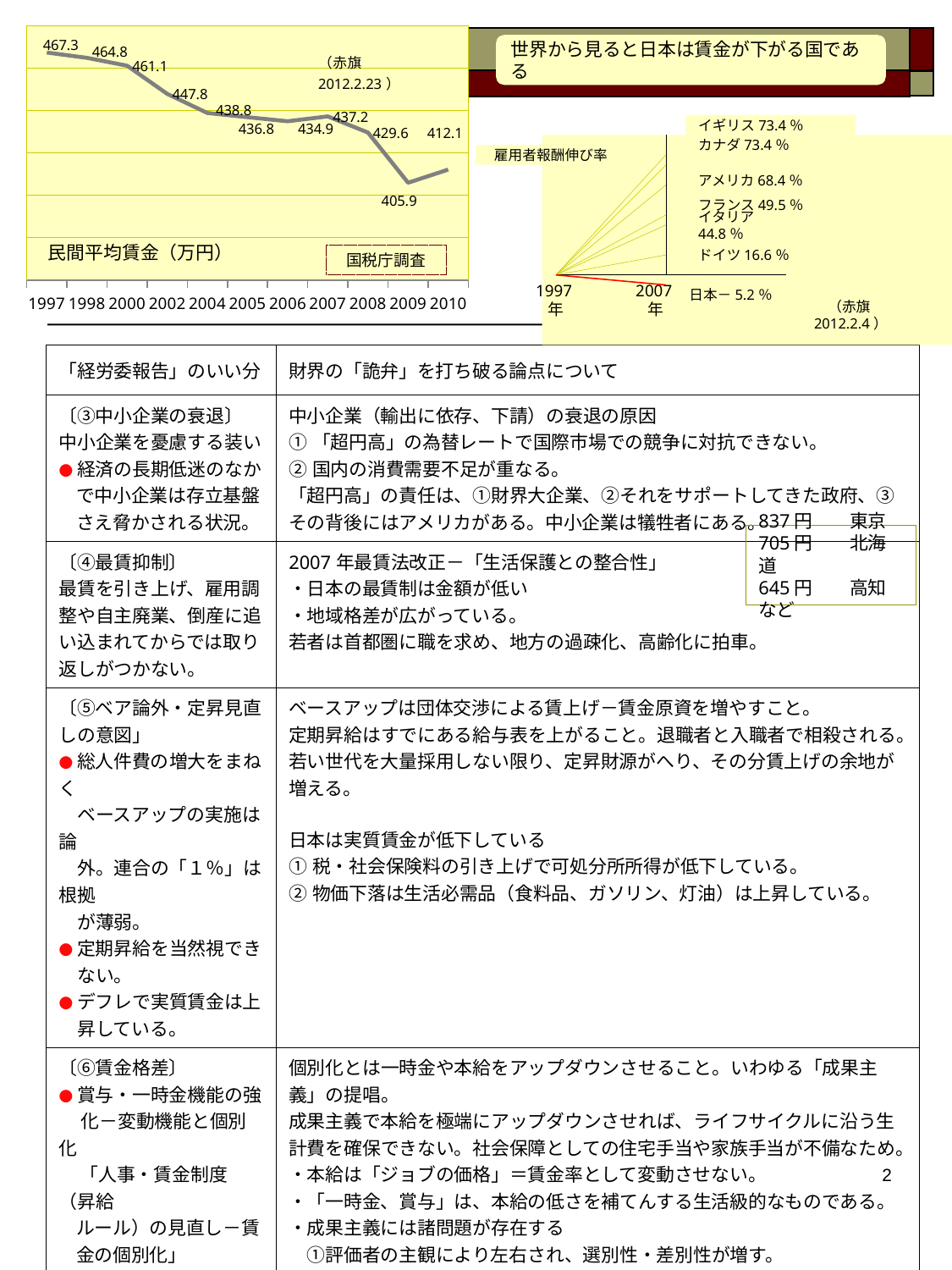
In the 民間平均賃金（万円） chart, what is the value for 2007? 437.2 In the 民間平均賃金（万円） chart, how many years are shown on the x axis? 11 In the 雇用者報酬伸び率 diagram on the right, what is the value shown for ドイツ? 16.6％ In the 民間平均賃金（万円） chart, which year has the lowest value? 2009 In the 民間平均賃金（万円） chart, what is the value for 1997? 467.3 In the 民間平均賃金（万円） chart, which is larger, the value for 2006 or the value for 2007? 2007 In the 民間平均賃金（万円） chart, do the values generally rise or fall from 1997 to 2009? fall In the 雇用者報酬伸び率 diagram on the right, what is the value shown for 日本? －5.2％ What kind of chart is the 民間平均賃金（万円） chart? line chart In the 民間平均賃金（万円） chart, what is the value for 2010? 412.1 In the 民間平均賃金（万円） chart, which year has the highest value? 1997 In the 民間平均賃金（万円） chart, what is the difference between the 1997 value and the 2009 value? 61.4